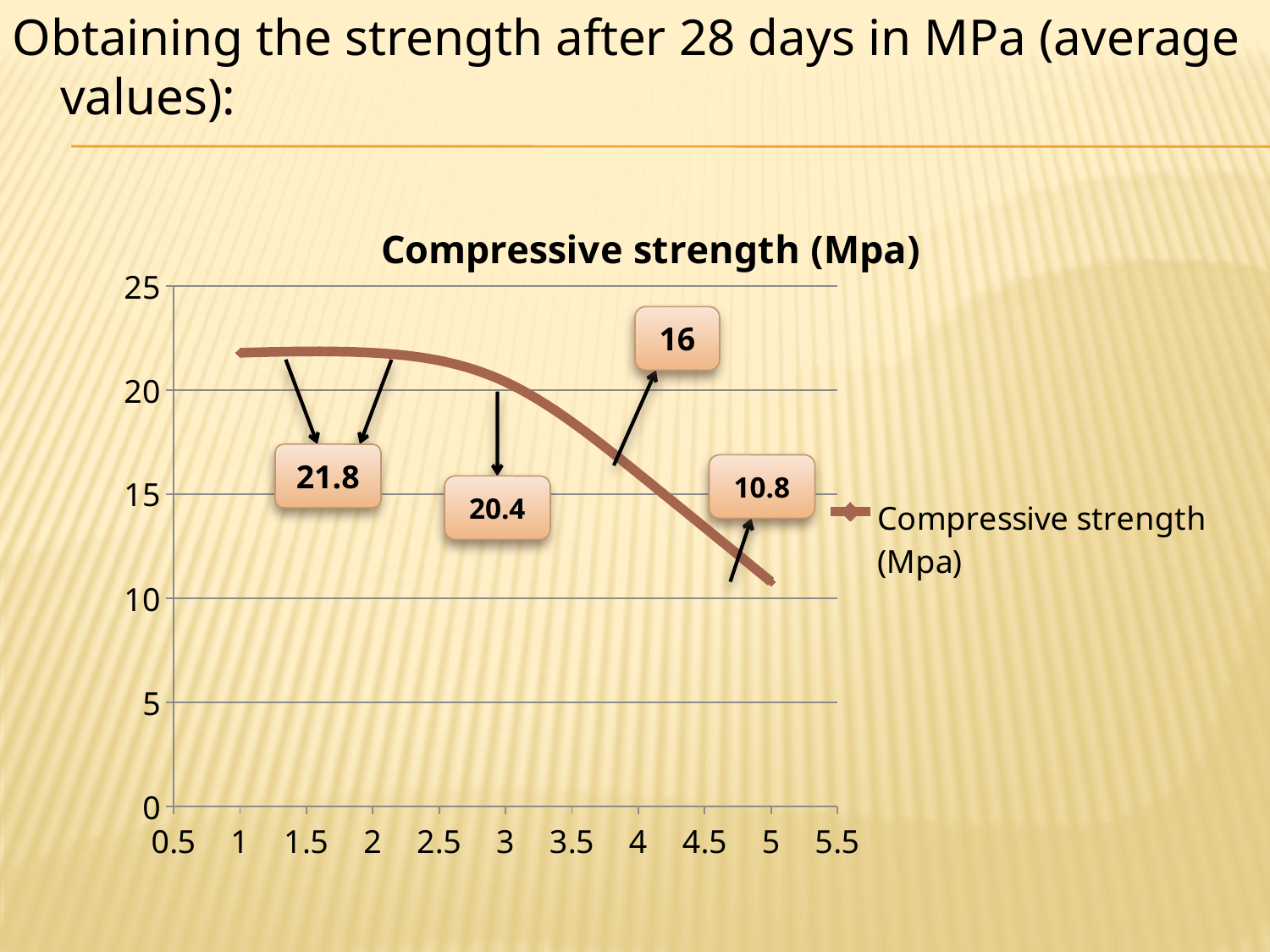
What kind of chart is shown on the slide? line chart What is the title of the chart? Compressive strength (Mpa) What is the difference between the labelled values at x = 3 (20.4) and x = 5 (10.8)? 9.6 What is the compressive strength value labelled at x = 4? 16 Do the compressive strength values rise or fall as x increases from 1 to 5? fall Is the compressive strength value at x = 5 greater or less than 15? less What is the highest labelled compressive strength value on the chart? 21.8 What is the compressive strength value labelled at x = 3? 20.4 What is the compressive strength value labelled at x = 5? 10.8 What is the compressive strength value labelled at x = 1 and x = 2? 21.8 What is the lowest labelled compressive strength value on the chart? 10.8 How many series does the legend list? 1